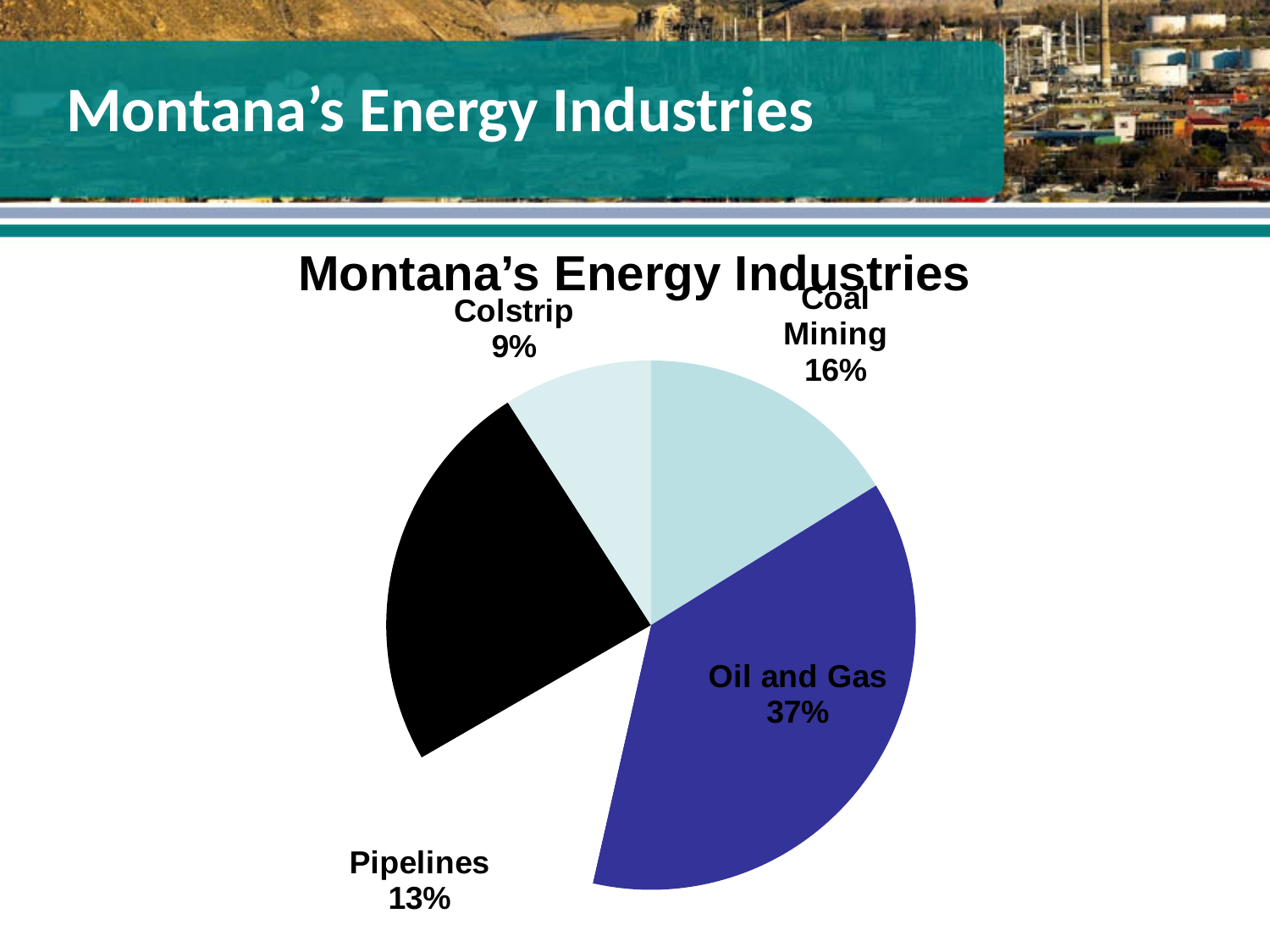
What kind of chart is shown on the slide? pie chart Which is larger, the percentage for Coal Mining or the percentage for Pipelines? Coal Mining Which industry has the largest share in the pie chart? Oil and Gas What percentage is shown for Oil and Gas? 37% What is the difference between the Oil and Gas percentage and the Coal Mining percentage? 21% What percentage is shown for Coal Mining? 16% What percentage is shown for Pipelines? 13% Which industry has the smallest share in the pie chart? Colstrip What is the title of the chart? Montana's Energy Industries How many slices are labelled in the pie chart? 4 What percentage is shown for Colstrip? 9% What colour is the Oil and Gas slice? blue